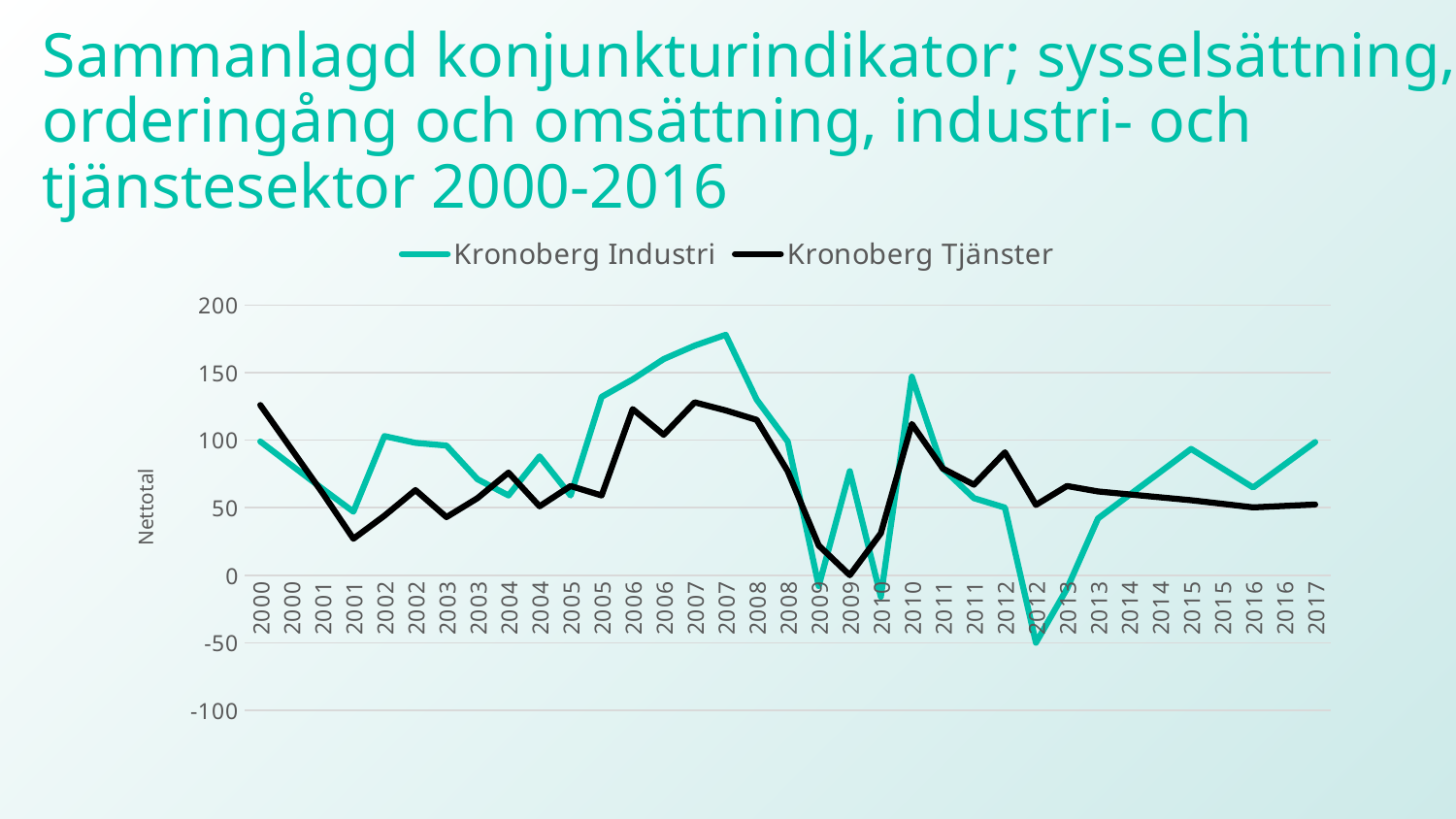
What kind of chart is shown on the slide? line chart At the second 2007 point, which series has the higher value, Kronoberg Industri or Kronoberg Tjänster? Kronoberg Industri How many series does the legend list? 2 Is the value of Kronoberg Tjänster at the first 2000 point greater or less than 100? greater At the second 2012 point, which series has the higher value, Kronoberg Industri or Kronoberg Tjänster? Kronoberg Tjänster How many labels are shown along the x axis? 35 Is the value of Kronoberg Tjänster at the second 2009 point greater or less than 50? less Is the value of Kronoberg Industri at the second 2010 point greater or less than 100? greater Which series reaches the lowest value anywhere on the chart? Kronoberg Industri What are the two series named in the legend? Kronoberg Industri and Kronoberg Tjänster What is the label on the vertical axis? Nettotal